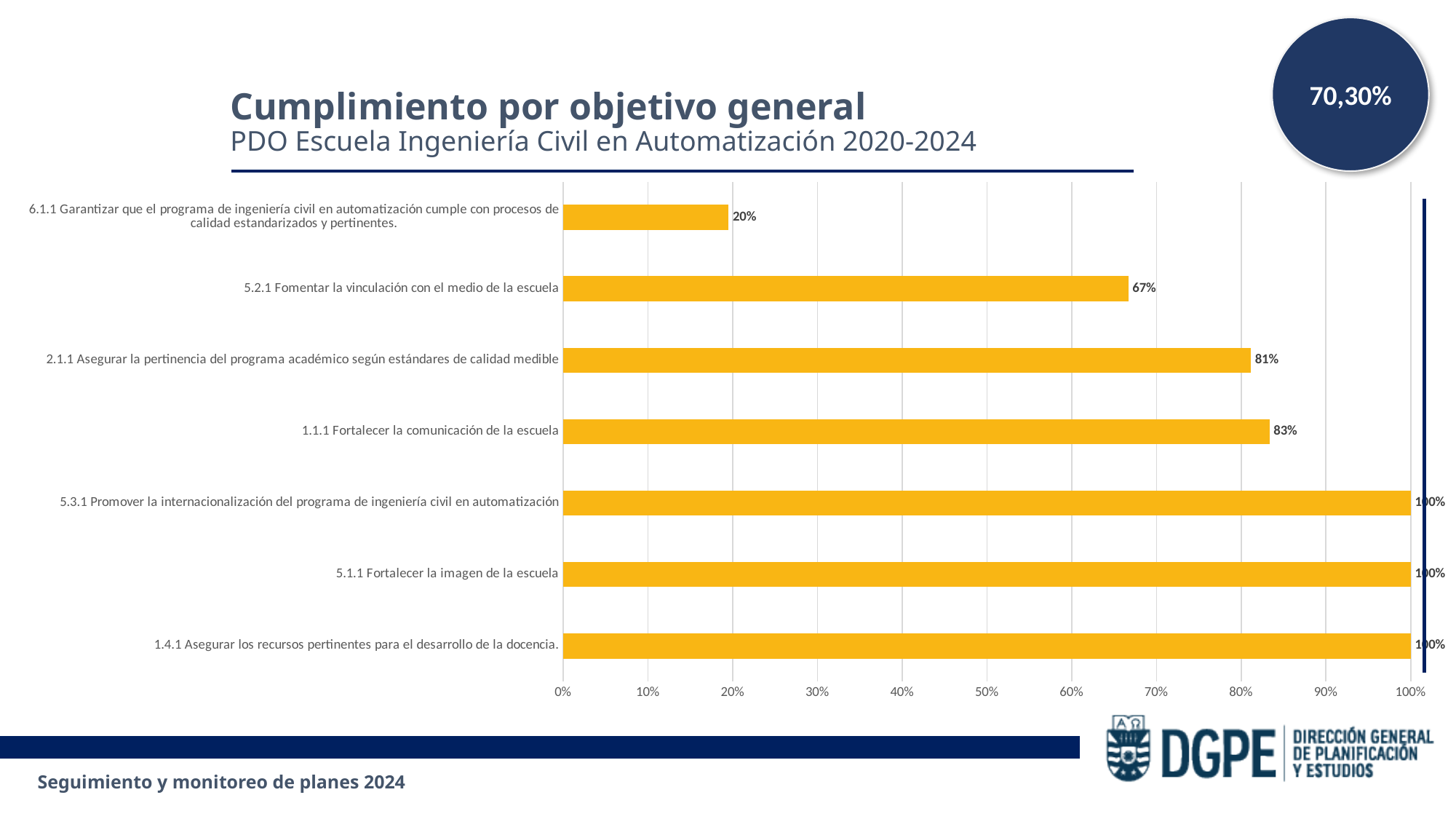
How many objectives (categories) are shown in the chart? 7 What is the difference between the values for objective 1.1.1 and objective 5.2.1? 16% Which is larger, the value for objective 2.1.1 or the value for objective 6.1.1? 2.1.1 What is the value for objective 5.2.1 (Fomentar la vinculación con el medio de la escuela)? 67% What overall percentage is shown in the circle at the top right of the slide? 70,30% Is the value for objective 5.2.1 greater or less than 50%? greater What is the value for objective 6.1.1 (Garantizar que el programa de ingeniería civil en automatización cumple con procesos de calidad estandarizados y pertinentes)? 20% How many objectives reach 100% in the chart? 3 What is the value for objective 1.1.1 (Fortalecer la comunicación de la escuela)? 83% What is the value for objective 2.1.1 (Asegurar la pertinencia del programa académico según estándares de calidad medible)? 81% Which objective has the lowest value in the chart? 6.1.1 Garantizar que el programa de ingeniería civil en automatización cumple con procesos de calidad estandarizados y pertinentes. What kind of chart is shown on the slide? Bar chart